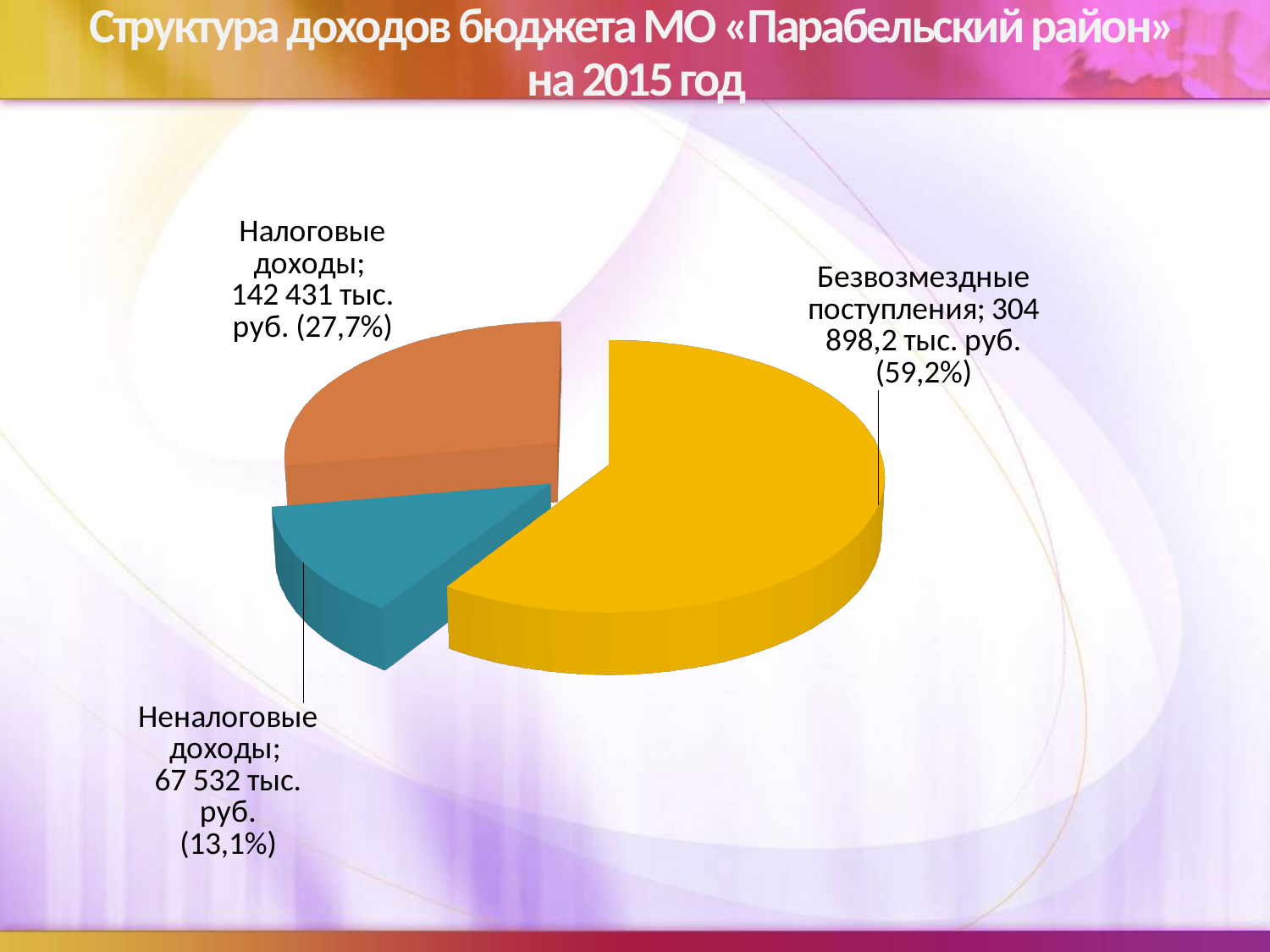
What kind of chart is shown on the slide? Pie chart How many slices does the pie chart have? 3 Which category has the largest share of the pie? Безвозмездные поступления What is the value for Безвозмездные поступления? 304 898,2 тыс. руб. What share of the pie does Безвозмездные поступления represent? 59,2% What colour is the slice for Безвозмездные поступления? Yellow What is the value for Налоговые доходы? 142 431 тыс. руб. Which is larger, Налоговые доходы or Неналоговые доходы? Налоговые доходы What share of the pie does Налоговые доходы represent? 27,7% Which category has the smallest share of the pie? Неналоговые доходы What is the value for Неналоговые доходы? 67 532 тыс. руб. What is the difference between Налоговые доходы and Неналоговые доходы? 74 899 тыс. руб.